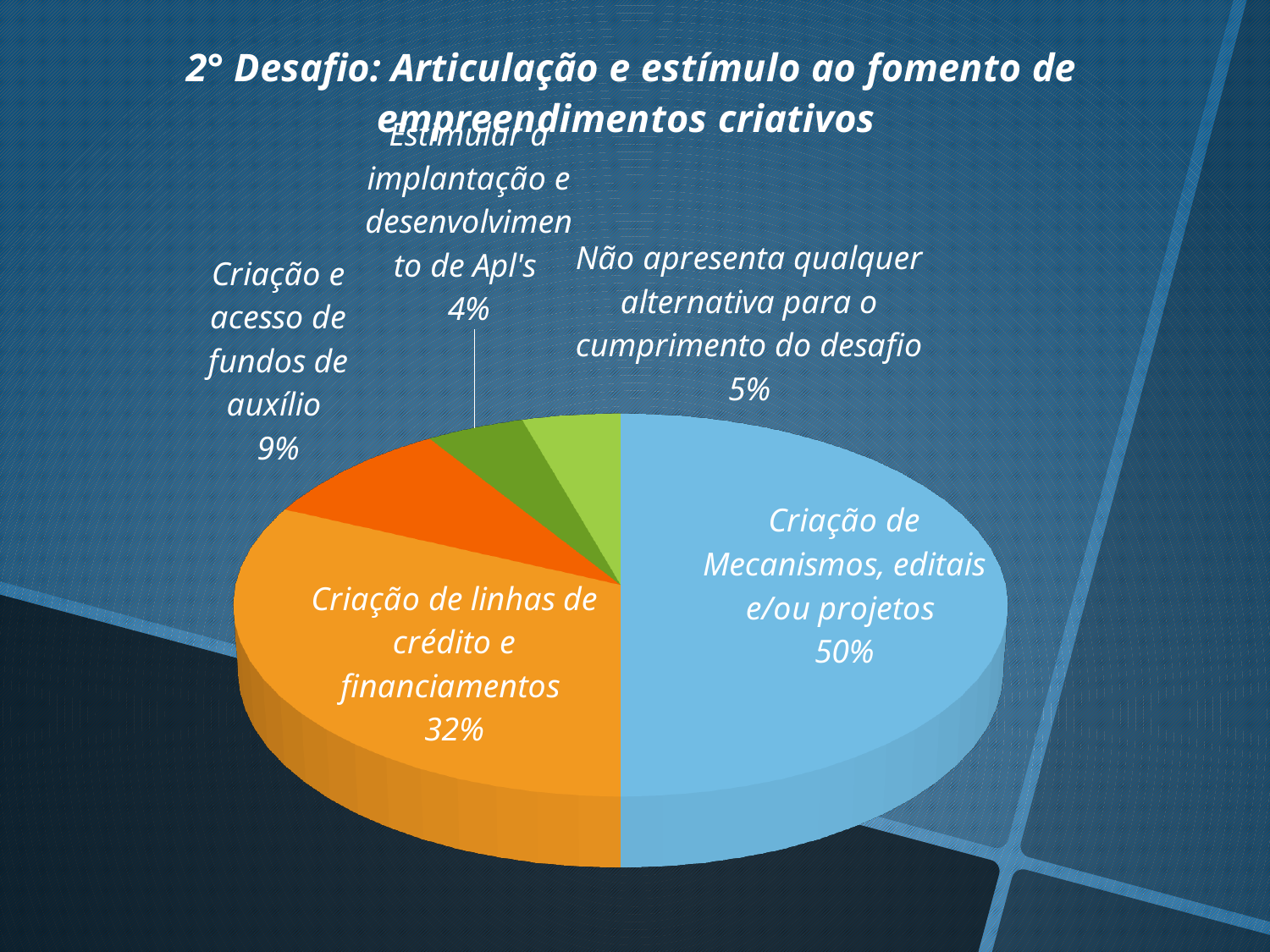
What percentage is shown for "Não apresenta qualquer alternativa para o cumprimento do desafio"? 5% Which category has the largest slice of the pie? Criação de Mecanismos, editais e/ou projetos How many slices does the pie chart have? 5 Which is larger: the share for "Criação e acesso de fundos de auxílio" or the share for "Não apresenta qualquer alternativa para o cumprimento do desafio"? Criação e acesso de fundos de auxílio What kind of chart is shown on the slide? Pie chart What percentage is shown for "Estimular a implantação e desenvolvimento de Apl's"? 4% What share of the pie does "Criação de Mecanismos, editais e/ou projetos" hold? 50% What percentage is shown for "Criação e acesso de fundos de auxílio"? 9% What percentage is shown for "Criação de linhas de crédito e financiamentos"? 32% What is the title of the slide containing the chart? 2° Desafio: Articulação e estímulo ao fomento de empreendimentos criativos What is the difference in percentage points between "Criação de Mecanismos, editais e/ou projetos" and "Criação de linhas de crédito e financiamentos"? 18 percentage points